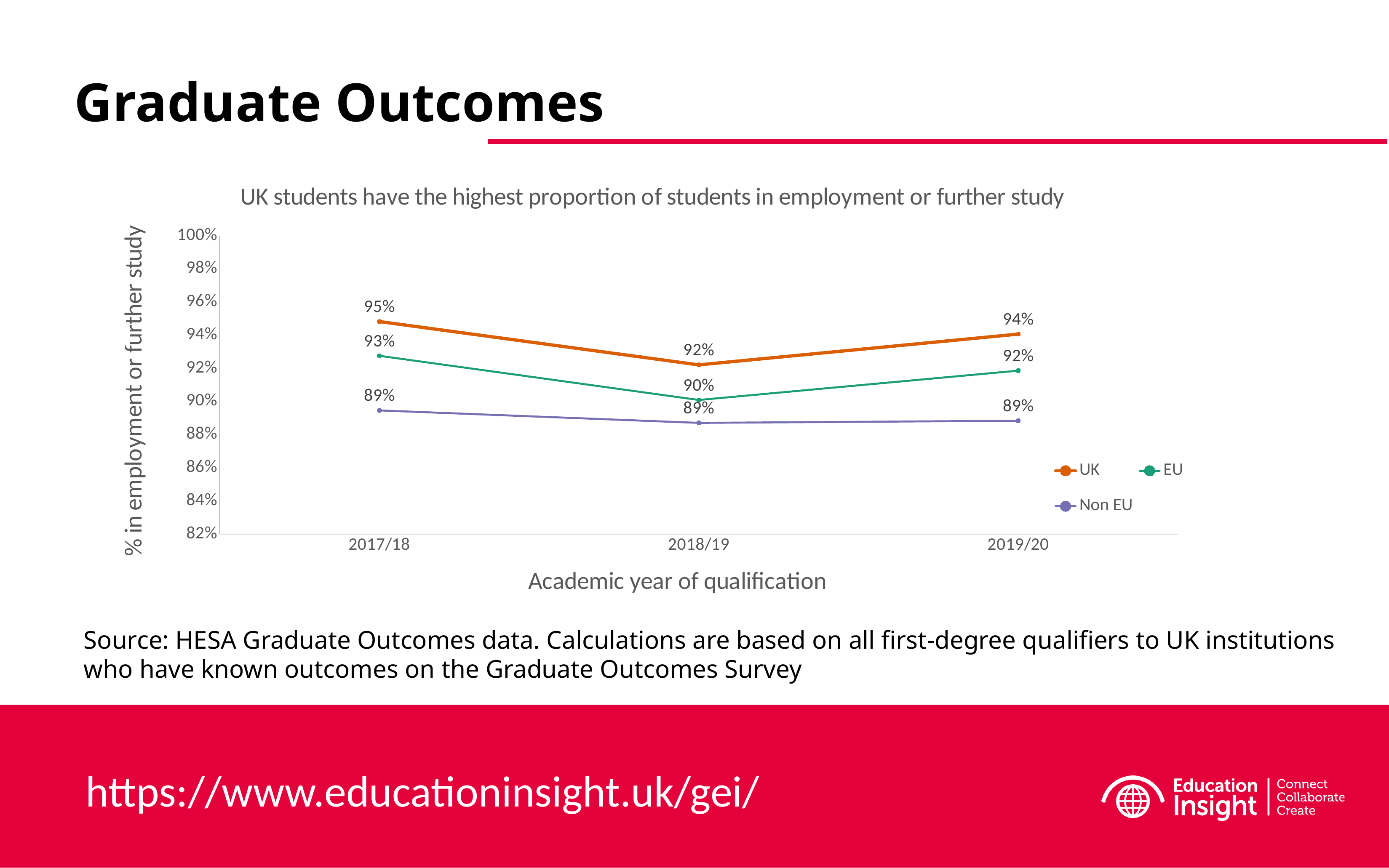
What is the difference between the UK and Non EU values in 2017/18? 6% What is the label of the y axis? % in employment or further study What is the value for UK in 2017/18? 95% What kind of chart is shown on the slide? Line chart How many series does the legend list? 3 Which series has the lowest value in 2017/18? Non EU What is the value for EU in 2019/20? 92% Which series has the highest value in 2019/20? UK Which is larger in 2018/19, the UK value or the EU value? UK How many academic years are shown on the x axis? 3 What is the value for Non EU in 2019/20? 89% What is the value for EU in 2018/19? 90%